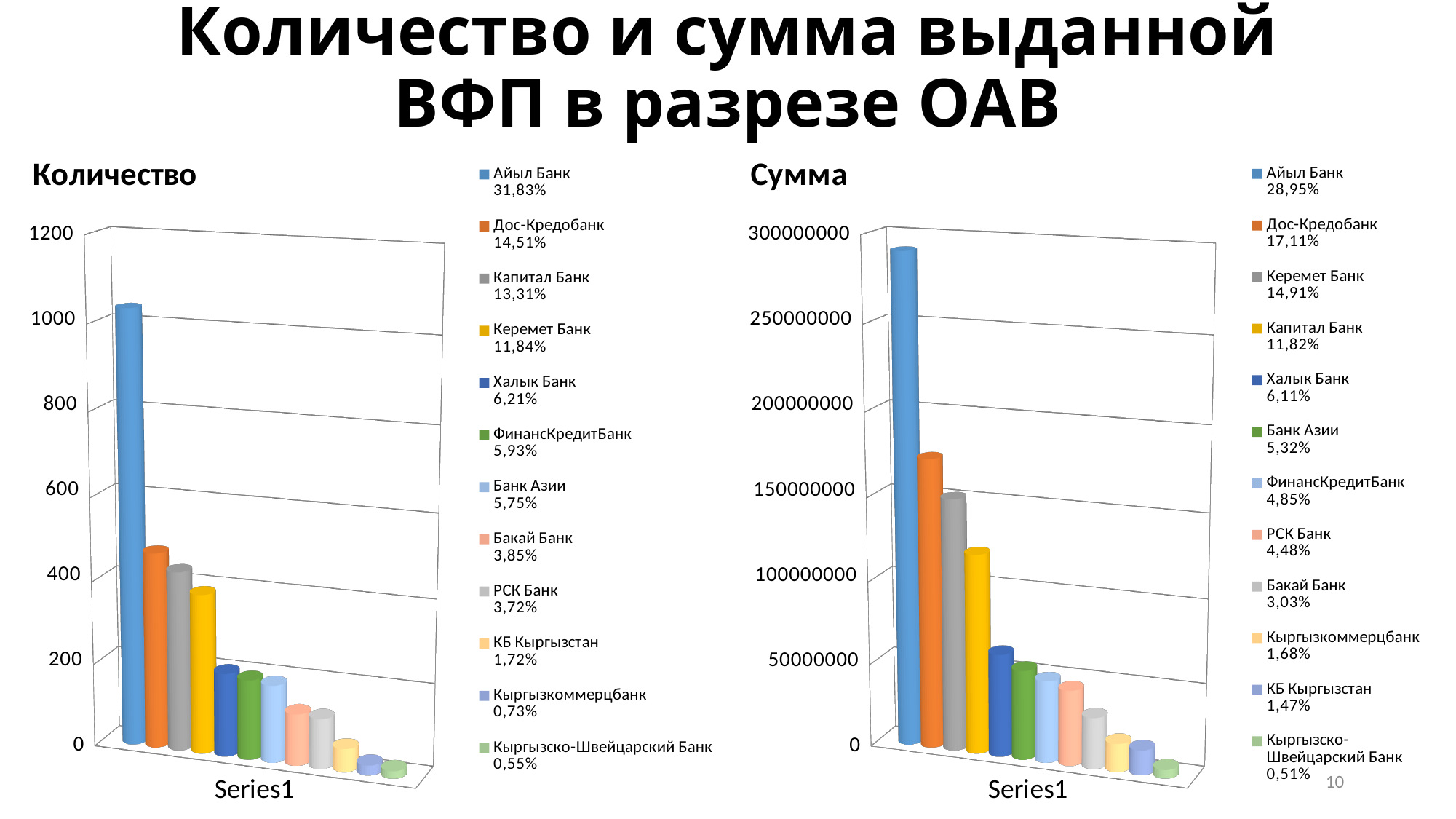
What label appears on the x axis of the "Сумма" chart? Series1 What kind of chart is the "Количество" chart? bar chart In the "Сумма" chart, which bank has the lowest bar? Кыргызско-Швейцарский Банк In the "Количество" chart, which is larger: the bar for Дос-Кредобанк or the bar for Керемет Банк? Дос-Кредобанк How many entries does the legend of the "Количество" chart list? 12 In the "Сумма" chart legend, what is the difference between the percentages for Айыл Банк and Дос-Кредобанк? 11,84% In the "Количество" chart, which bank has the highest bar? Айыл Банк In the "Количество" chart, what percentage is shown in the legend for Айыл Банк? 31,83% In the "Сумма" chart, what percentage is shown in the legend for Дос-Кредобанк? 17,11% In the "Сумма" chart, is the value for Айыл Банк greater or less than 250000000? greater